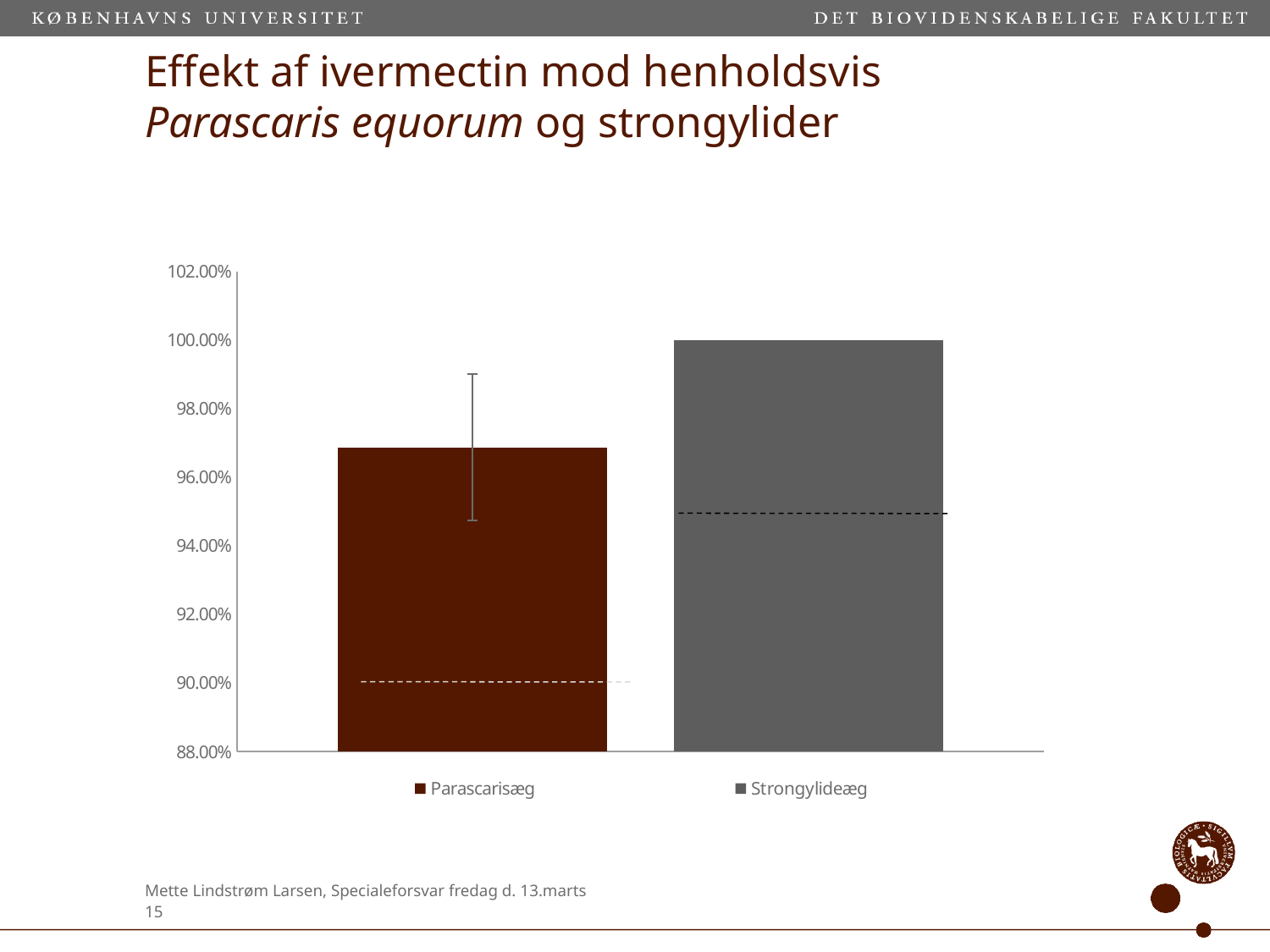
Do the bar values rise or fall from left to right? rise What are the two entries in the chart legend? Parascarisæg and Strongylideæg How many series does the legend list? 2 Is the value for Parascarisæg greater or less than 96.00%? greater What kind of chart is shown on the slide? bar chart Which series has the highest bar? Strongylideæg Is the value for Parascarisæg greater or less than 98.00%? less Which is larger, the value for Parascarisæg or the value for Strongylideæg? Strongylideæg What value does the Strongylideæg bar reach on the y axis? 100.00% How many bars are plotted in the chart? 2 Which bar has an error bar drawn on it? Parascarisæg Which series has the lowest bar? Parascarisæg